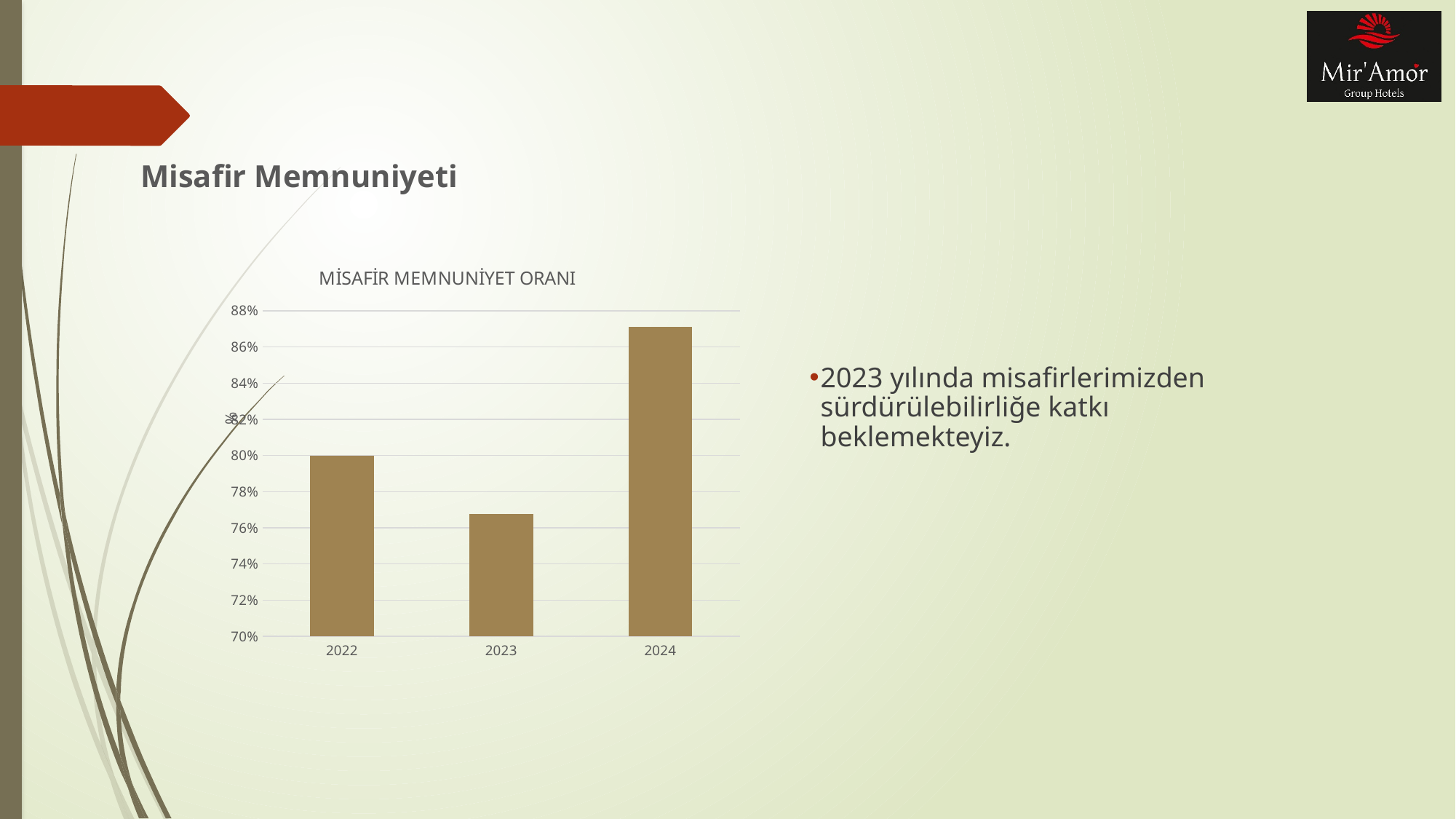
What is the guest satisfaction rate for 2022? 80% Does the guest satisfaction rate rise or fall from 2023 to 2024? rise Which year has a higher guest satisfaction rate, 2022 or 2023? 2022 Which year has the highest guest satisfaction rate in the chart? 2024 Which year has the lowest guest satisfaction rate in the chart? 2023 Is the value for 2024 greater or less than 86%? greater What is the lowest value shown on the y axis of the chart? 70% What is the title of the chart? MİSAFİR MEMNUNİYET ORANI Is the value for 2023 greater or less than 76%? greater What kind of chart is shown on the slide? bar chart How many years are shown on the x axis of the chart? 3 Is the value for 2023 greater or less than 78%? less